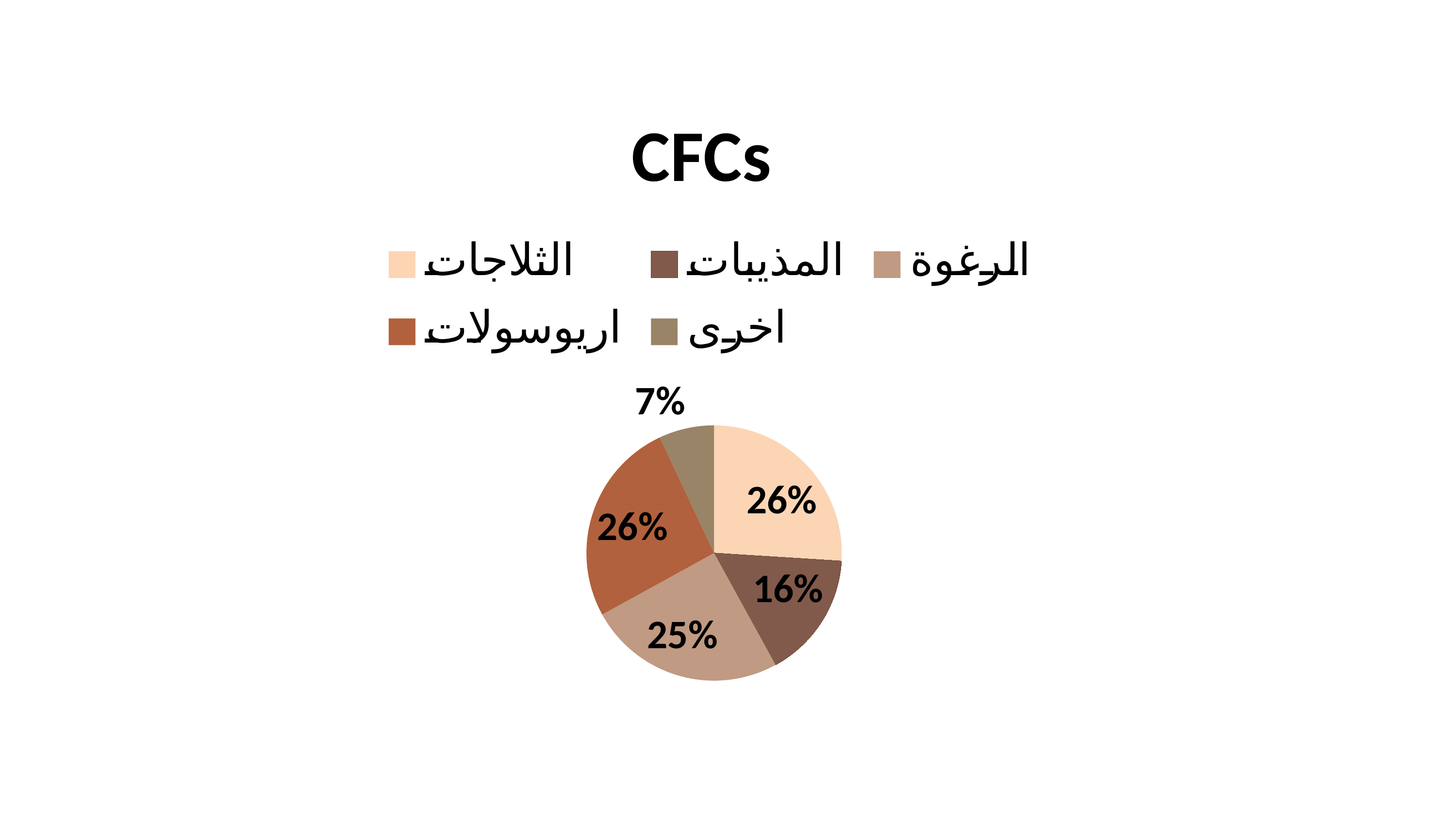
What is the difference between the shares of الرغوة and المذيبات? 9% Which is larger, the share for المذيبات or the share for اخرى? المذيبات How many slices does the pie chart have? 5 What share of the pie does الثلاجات have? 26% What share of the pie does المذيبات have? 16% Which category has the smallest slice of the pie? اخرى What share of the pie does اريوسولات have? 26% What is the title of the chart? CFCs How many entries does the legend list? 5 What type of chart is shown on the slide? pie chart